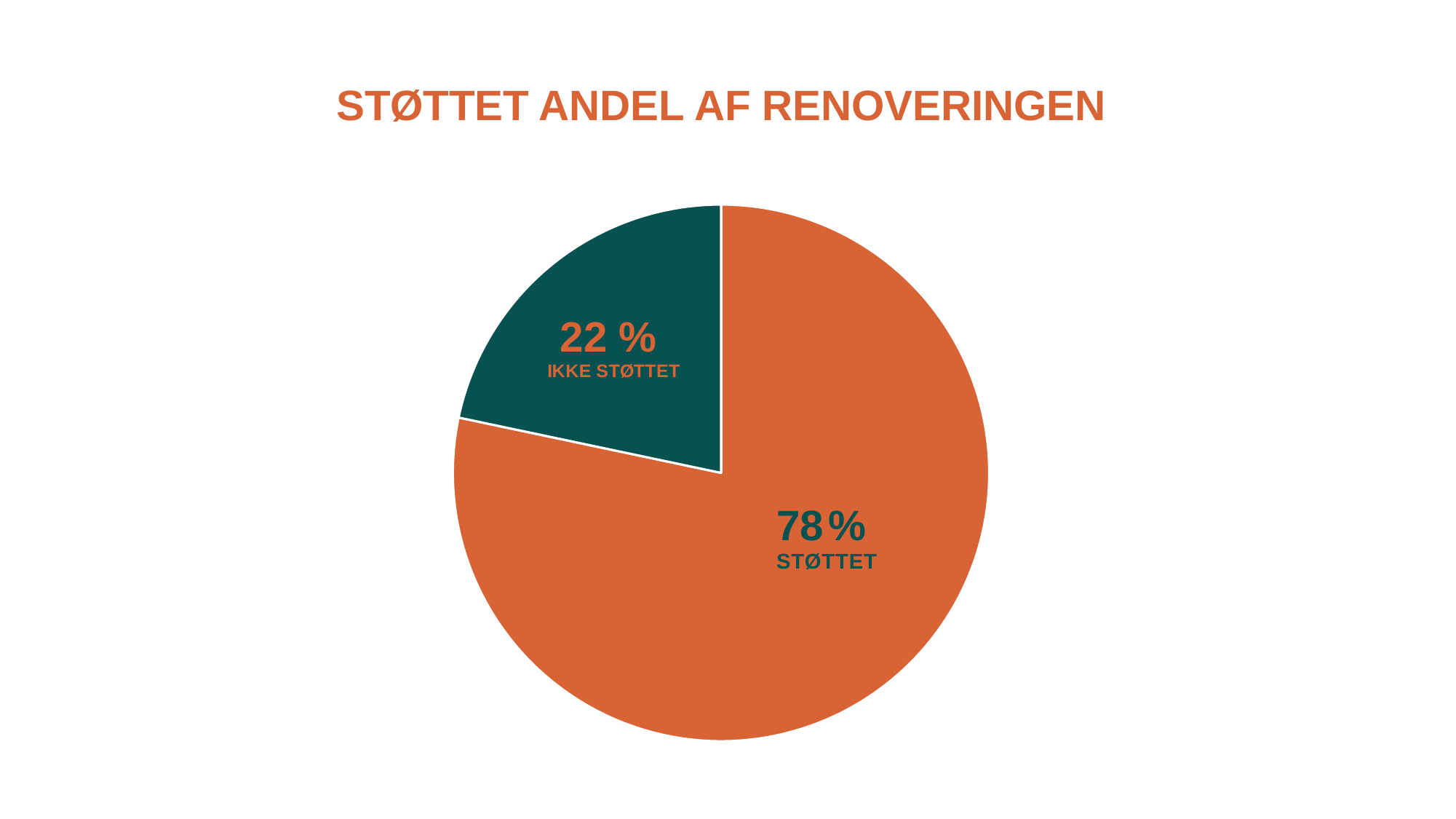
Which slice is the largest? STØTTET How many slices does the pie chart have? 2 What is the title of the chart? STØTTET ANDEL AF RENOVERINGEN What colour is the IKKE STØTTET slice? dark green Which slice is the smallest? IKKE STØTTET Which is larger, the STØTTET slice or the IKKE STØTTET slice? STØTTET What kind of chart is shown on the slide? pie chart What share of the pie is labelled IKKE STØTTET? 22 % What is the difference in percentage points between the STØTTET and IKKE STØTTET slices? 56 What share of the pie is labelled STØTTET? 78 % What is the total of the two slices' percentages? 100 %